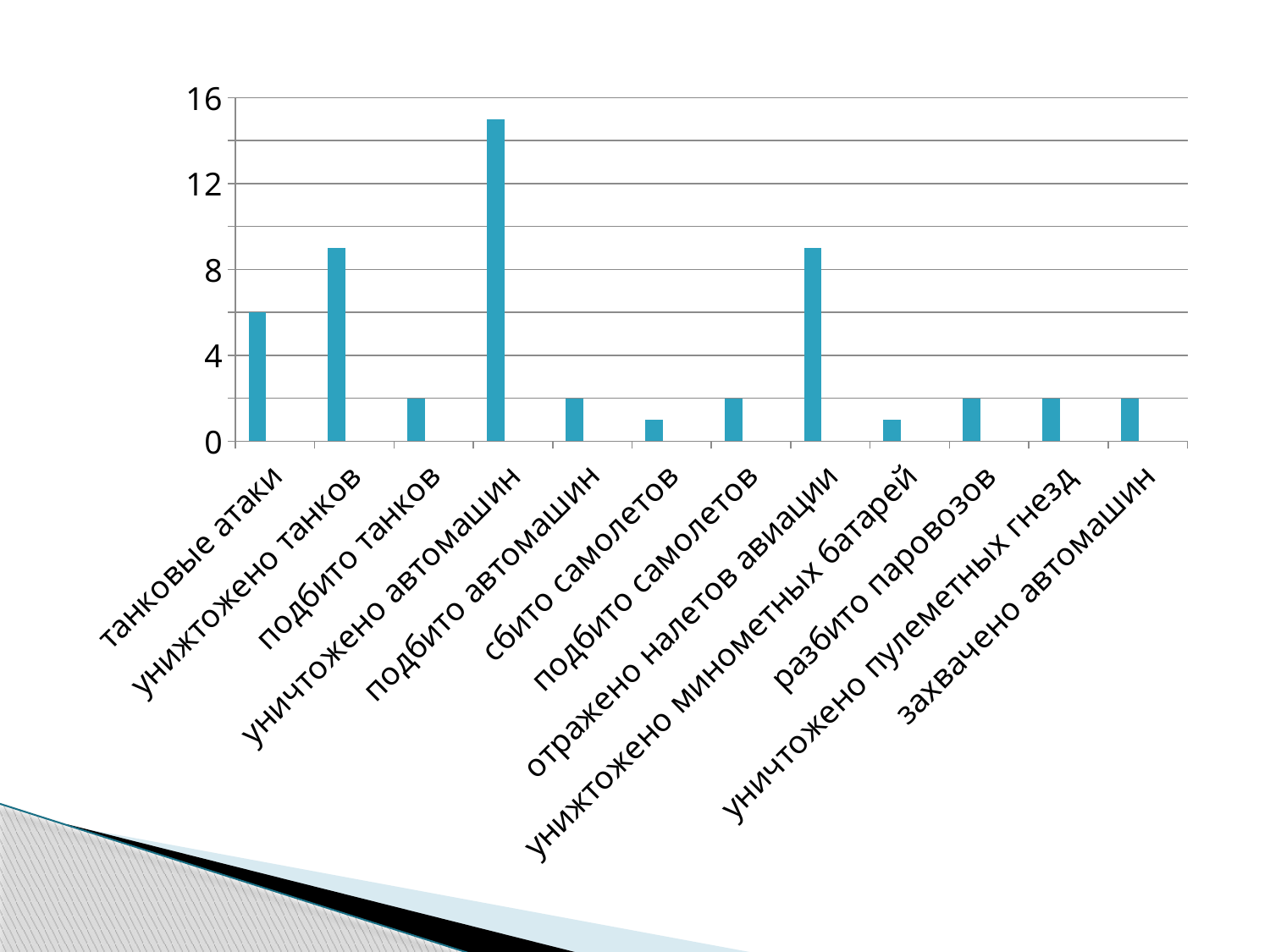
Which category has the highest bar in the chart? уничтожено автомашин What kind of chart is shown on the slide? bar chart Which is larger, the value for уничтожено танков or the value for подбито танков? уничтожено танков What is the highest value labelled on the vertical axis of the chart? 16 Is the value for отражено налетов авиации greater or less than 8? greater How many categories are shown on the x axis of the chart? 12 Is the value for танковые атаки greater or less than 4? greater Which is larger, the value for уничтожено автомашин or the value for подбито автомашин? уничтожено автомашин Is the value for сбито самолетов greater or less than 4? less